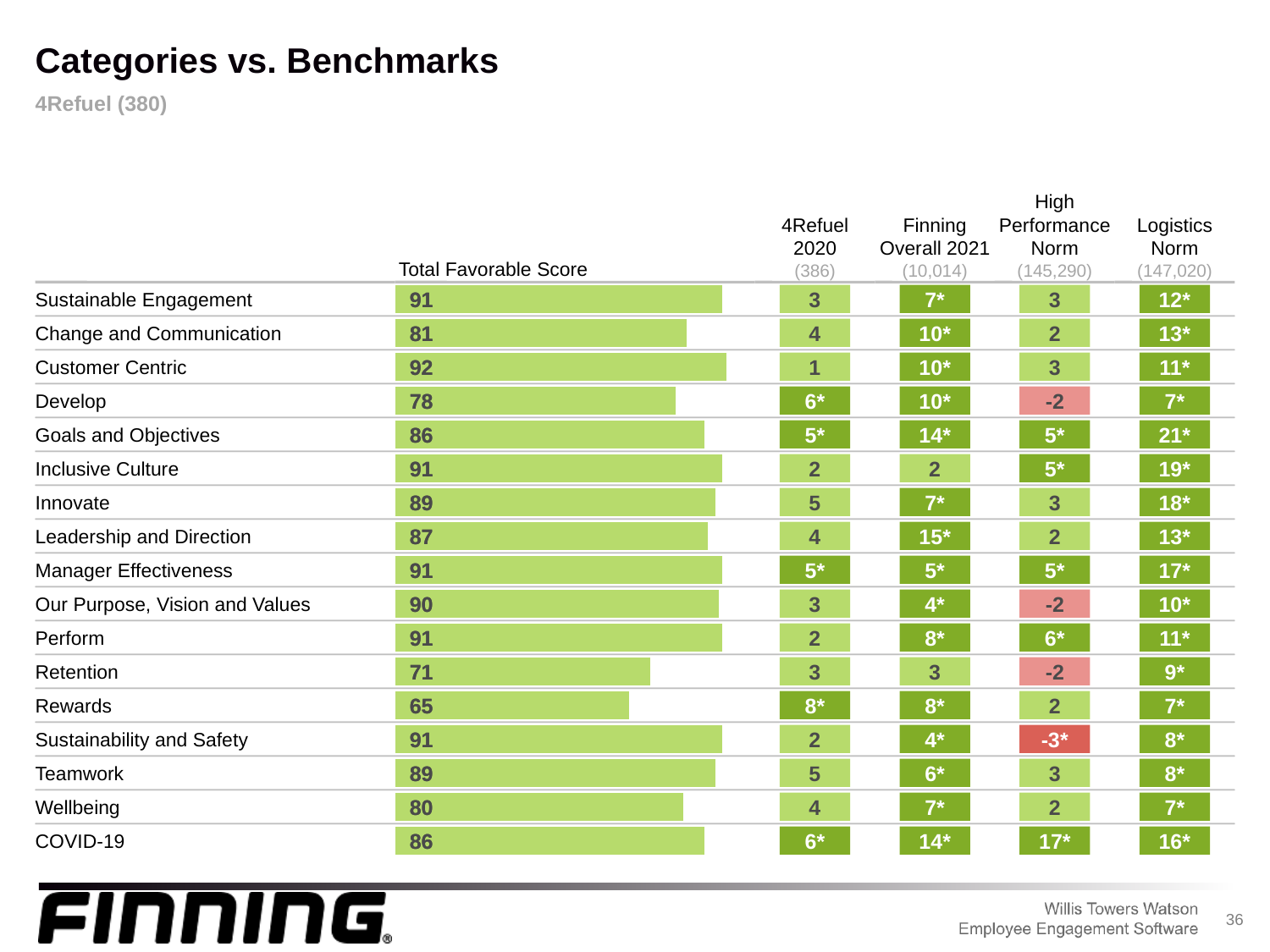
What kind of chart is used to show the Total Favorable Score? Bar chart What is the difference between the Total Favorable Score for Goals and Objectives and Change and Communication? 5 Which has a higher Total Favorable Score, Develop or Wellbeing? Wellbeing How many categories are listed in the Total Favorable Score chart? 17 What is the Total Favorable Score for Customer Centric? 92 What is the value shown for COVID-19 in the High Performance Norm column? 17* What is the difference between the Total Favorable Score for Customer Centric and Rewards? 27 Which category has the highest Total Favorable Score? Customer Centric What is the value shown for Goals and Objectives in the Logistics Norm column? 21* Which category has the lowest Total Favorable Score? Rewards How many benchmark comparison columns are shown to the right of the Total Favorable Score bars? 4 What is the Total Favorable Score for Retention? 71